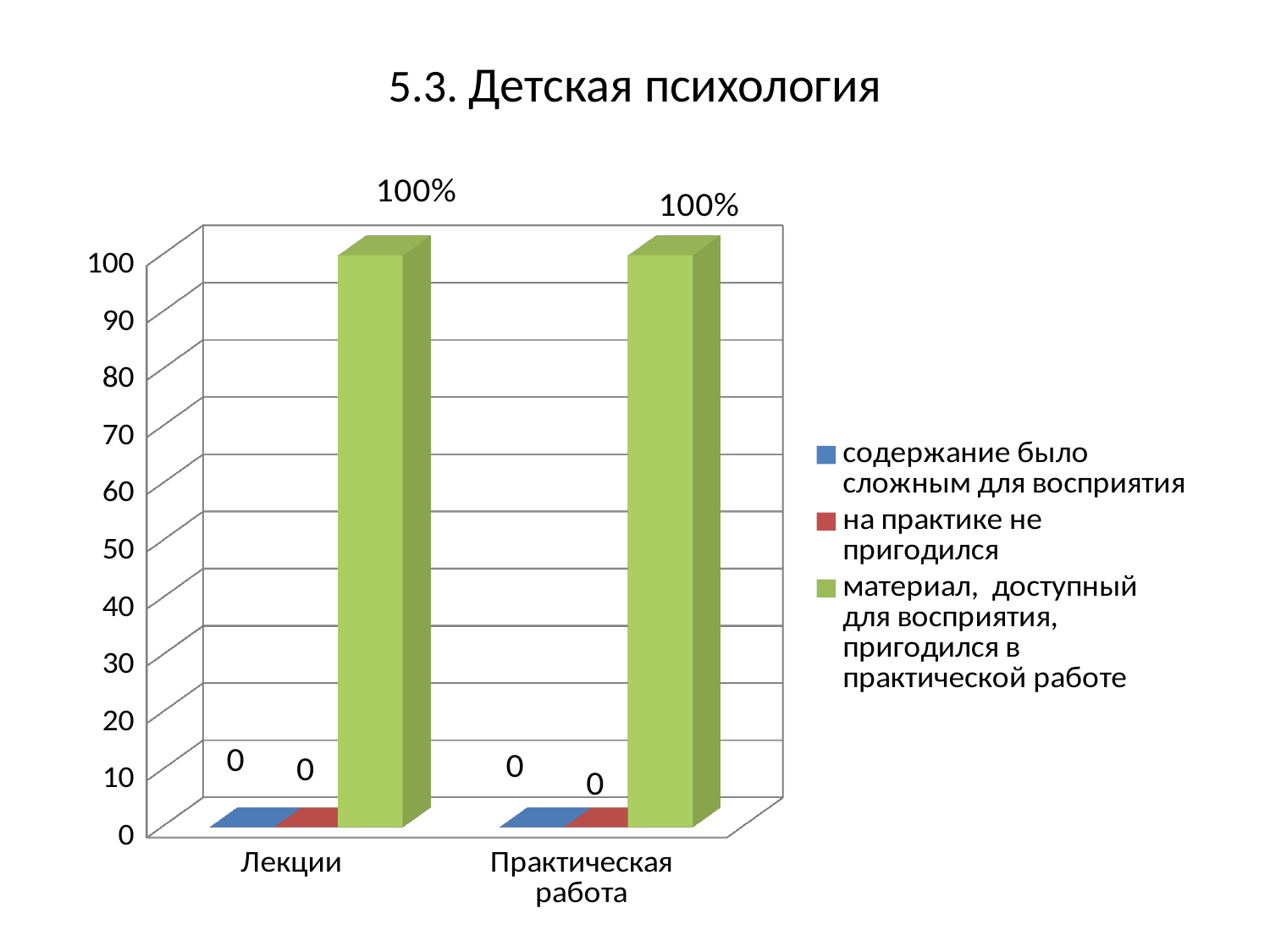
How many series does the legend list? 3 Which is larger for Лекции: "на практике не пригодился" or "материал, доступный для восприятия, пригодился в практической работе"? материал, доступный для восприятия, пригодился в практической работе What colour are the bars for "материал, доступный для восприятия, пригодился в практической работе"? green What is the value for "материал, доступный для восприятия, пригодился в практической работе" for Лекции? 100% Is the value for "материал, доступный для восприятия, пригодился в практической работе" for Практическая работа greater or less than 50? greater What is the value for "на практике не пригодился" for Практическая работа? 0 What is the title of the slide? 5.3. Детская психология How many categories are shown on the x axis? 2 What is the value for "содержание было сложным для восприятия" for Лекции? 0 What is the value for "материал, доступный для восприятия, пригодился в практической работе" for Практическая работа? 100% What kind of chart is shown on the slide? bar chart Which series has the highest value for Лекции? материал, доступный для восприятия, пригодился в практической работе